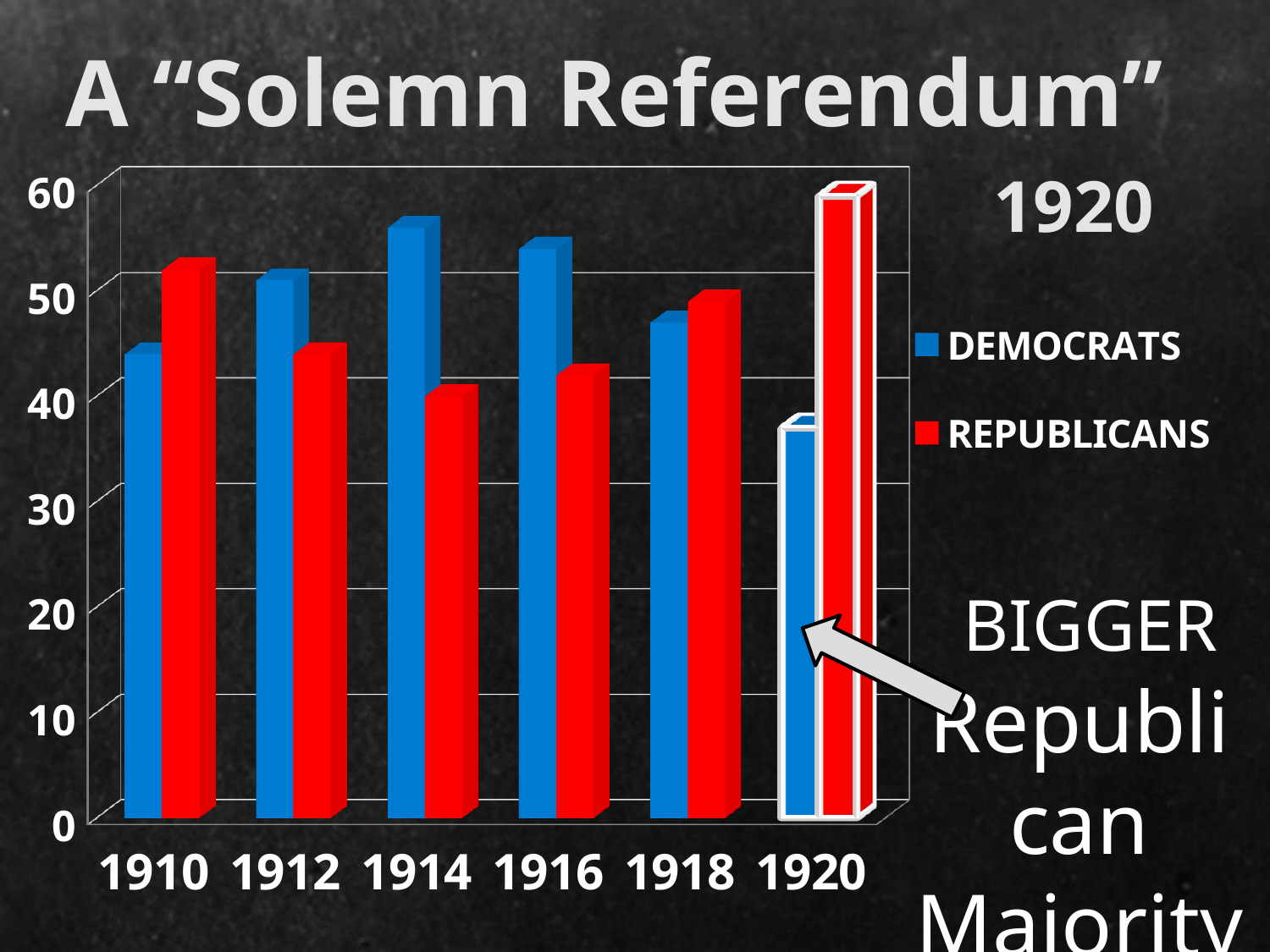
How many years are shown on the x axis of the chart? 6 Is the DEMOCRATS value for 1920 greater or less than 40? less Which series is shown in red in the chart? REPUBLICANS In which year is the REPUBLICANS value highest? 1920 Do the REPUBLICANS values rise or fall from 1914 to 1920? rise What is the title of the slide containing the chart? A "Solemn Referendum" In 1914, which series has the larger value, DEMOCRATS or REPUBLICANS? DEMOCRATS How many series does the chart's legend list? 2 What kind of chart is shown on the slide? bar chart In 1910, which series has the larger value, DEMOCRATS or REPUBLICANS? REPUBLICANS In which year is the DEMOCRATS value lowest? 1920 Is the REPUBLICANS value for 1920 greater or less than 50? greater